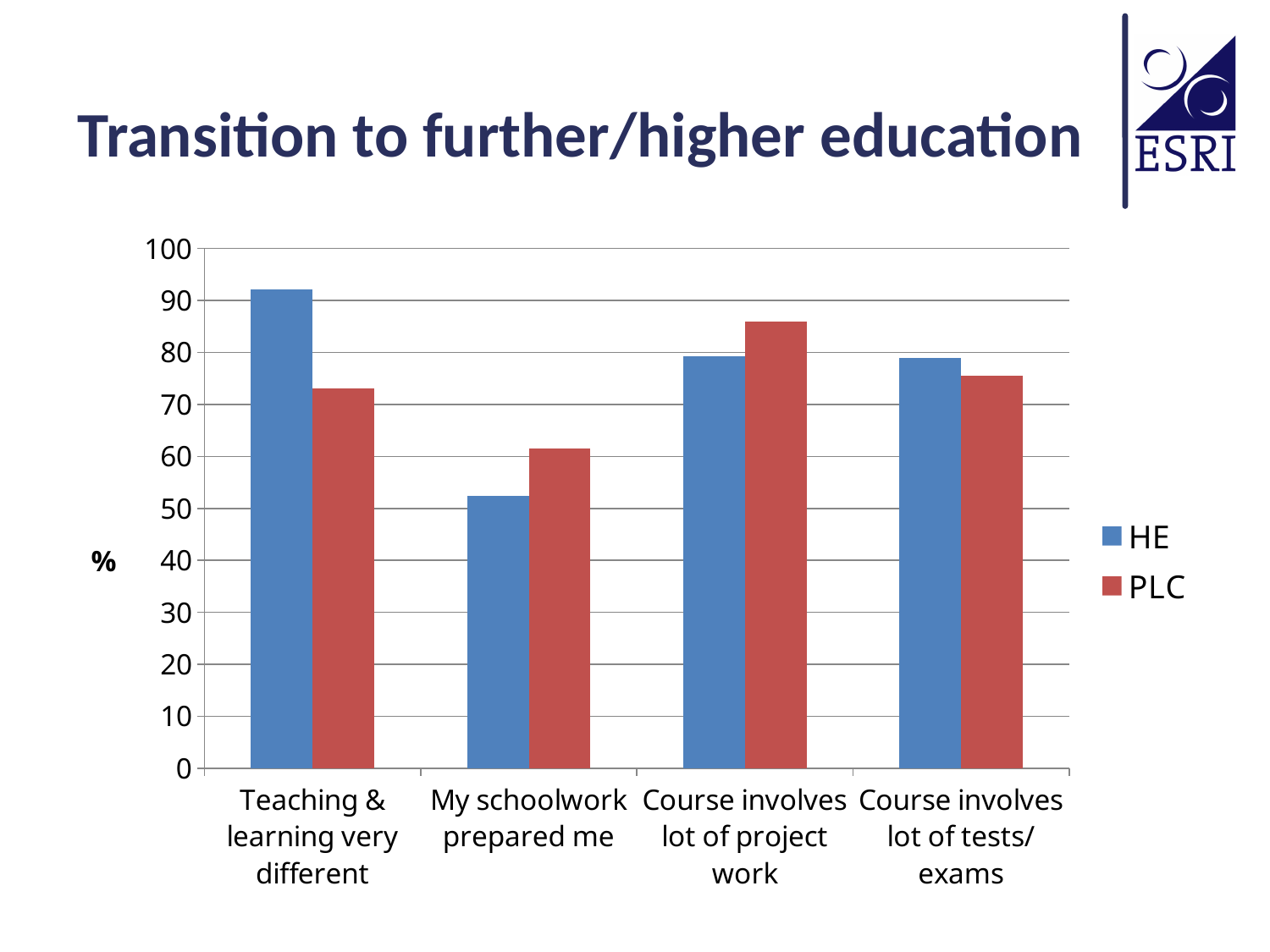
Is the HE value for 'My schoolwork prepared me' greater or less than 60? less What is the label on the vertical axis? % For which category is the HE value highest? Teaching & learning very different Is the HE value for 'Teaching & learning very different' greater or less than 80? greater For 'Teaching & learning very different', which series has the larger value, HE or PLC? HE What kind of chart is shown on the slide? bar chart How many categories are shown on the x axis? 4 For which category is the PLC value lowest? My schoolwork prepared me For 'My schoolwork prepared me', which series has the larger value, HE or PLC? PLC How many series does the legend list? 2 For which category is the HE value lowest? My schoolwork prepared me For which category is the PLC value highest? Course involves lot of project work